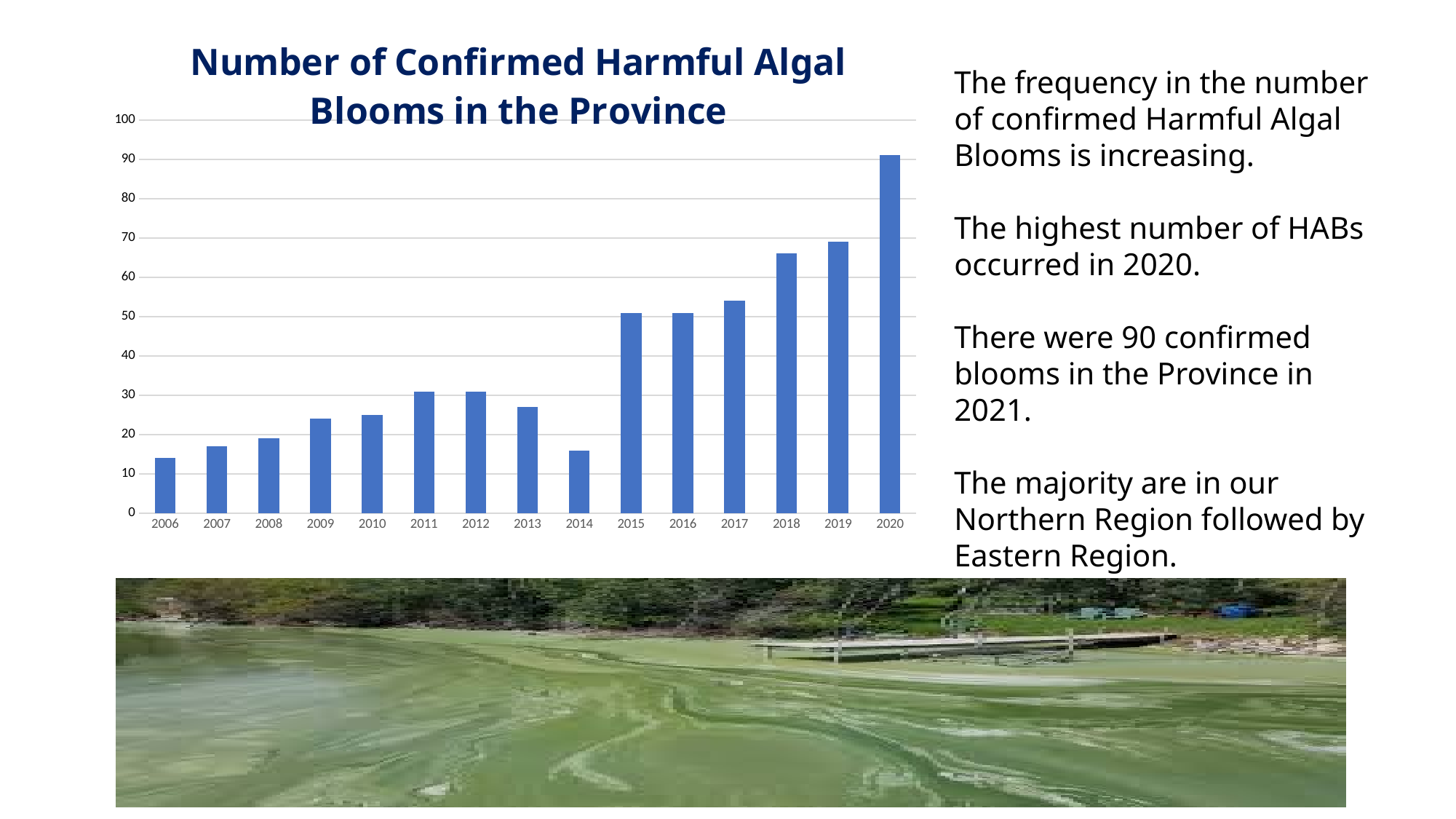
Is the value for 2020 greater or less than 80? greater Which year has the larger value, 2013 or 2014? 2013 Is the value for 2014 greater or less than 20? less Is the value for 2019 greater or less than 60? greater How many years are shown on the x axis of the chart? 15 Overall, do the values rise or fall from 2006 to 2020? rise What kind of chart is shown on the slide? bar chart Which year has the highest number of confirmed harmful algal blooms? 2020 What is the title of the chart? Number of Confirmed Harmful Algal Blooms in the Province Which year has the larger value, 2014 or 2015? 2015